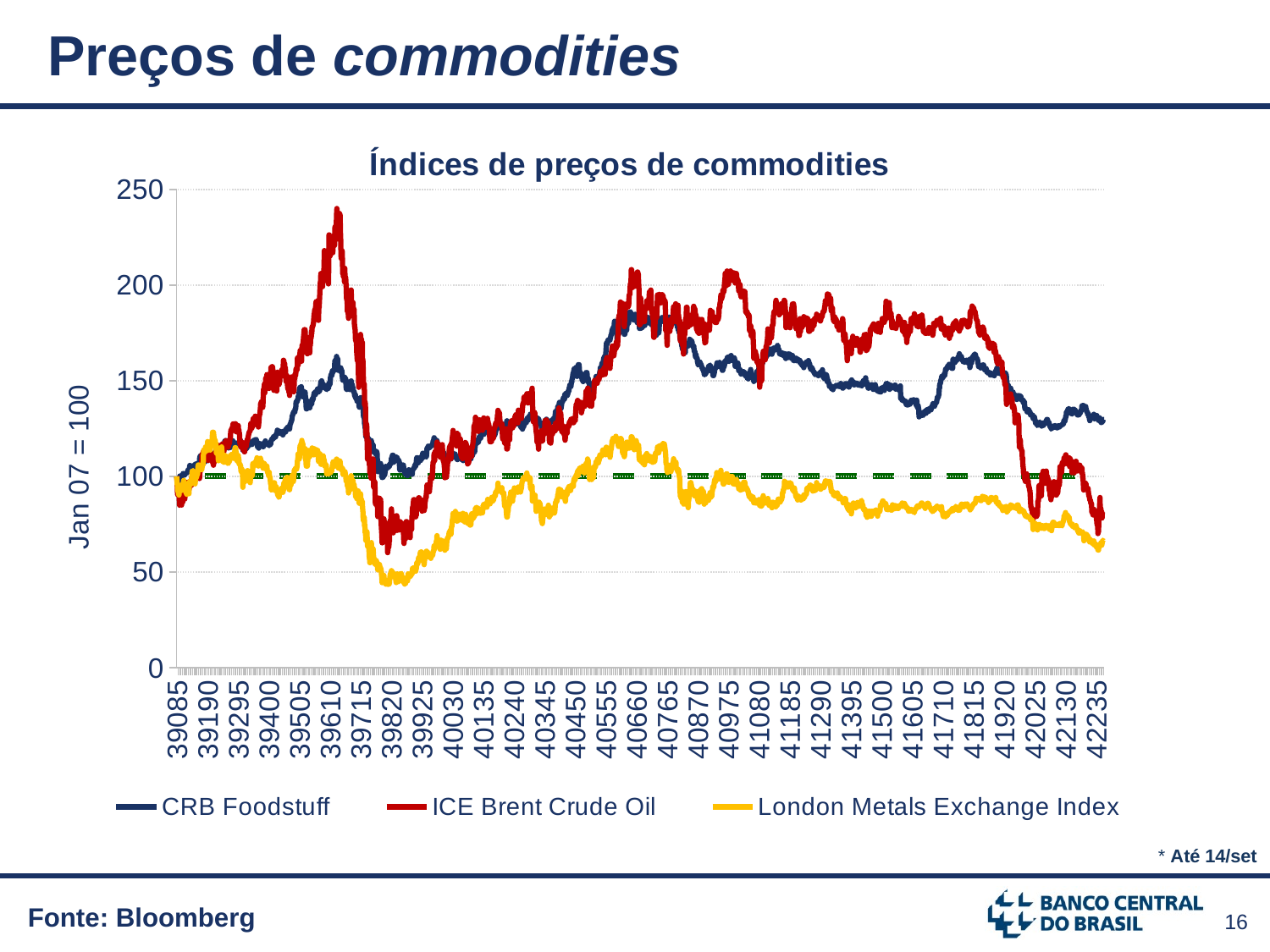
Which series is lowest at the right-hand end of the chart? London Metals Exchange Index What is the label on the vertical axis of the chart? Jan 07 = 100 Which series reaches the highest peak on the chart? ICE Brent Crude Oil Is the value of the London Metals Exchange Index at the right-hand end of the chart greater or less than 100? less How many series does the legend list? 3 Does the London Metals Exchange Index end higher or lower than it starts? lower What is the title of the chart? Índices de preços de commodities Is the peak value of ICE Brent Crude Oil greater or less than 200? greater What kind of chart is shown on the slide? line chart At the right-hand end of the chart, which is higher: CRB Foodstuff or ICE Brent Crude Oil? CRB Foodstuff Is the lowest point of the London Metals Exchange Index greater or less than 50? less